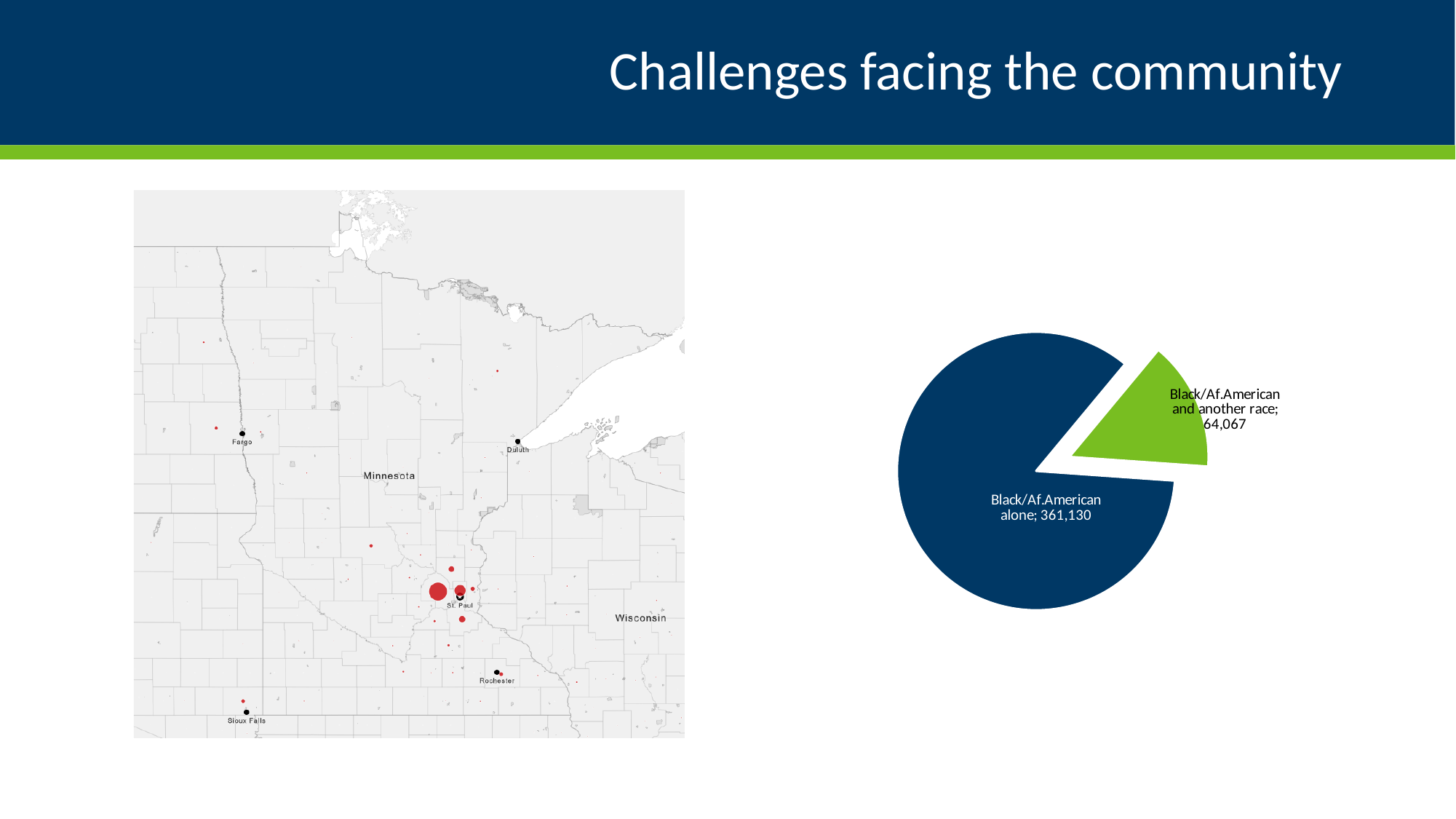
In the pie chart on the right, which category has the smallest slice? Black/Af.American and another race What kind of chart is shown on the right side of the slide? Pie chart In the pie chart on the right, what share of the total does Black/Af.American and another race represent, to one decimal place? 15.1% In the pie chart on the right, what colour is the slice for Black/Af.American alone? Dark blue In the pie chart on the right, which is larger: Black/Af.American alone or Black/Af.American and another race? Black/Af.American alone How many slices does the pie chart on the right have? 2 In the pie chart on the right, what is the value for Black/Af.American alone? 361,130 In the pie chart on the right, what colour is the slice for Black/Af.American and another race? Green In the pie chart on the right, what is the total of the two slices? 425,197 In the pie chart on the right, what is the value for Black/Af.American and another race? 64,067 In the pie chart on the right, which category has the largest slice? Black/Af.American alone In the pie chart on the right, what is the difference between the value for Black/Af.American alone and the value for Black/Af.American and another race? 297,063